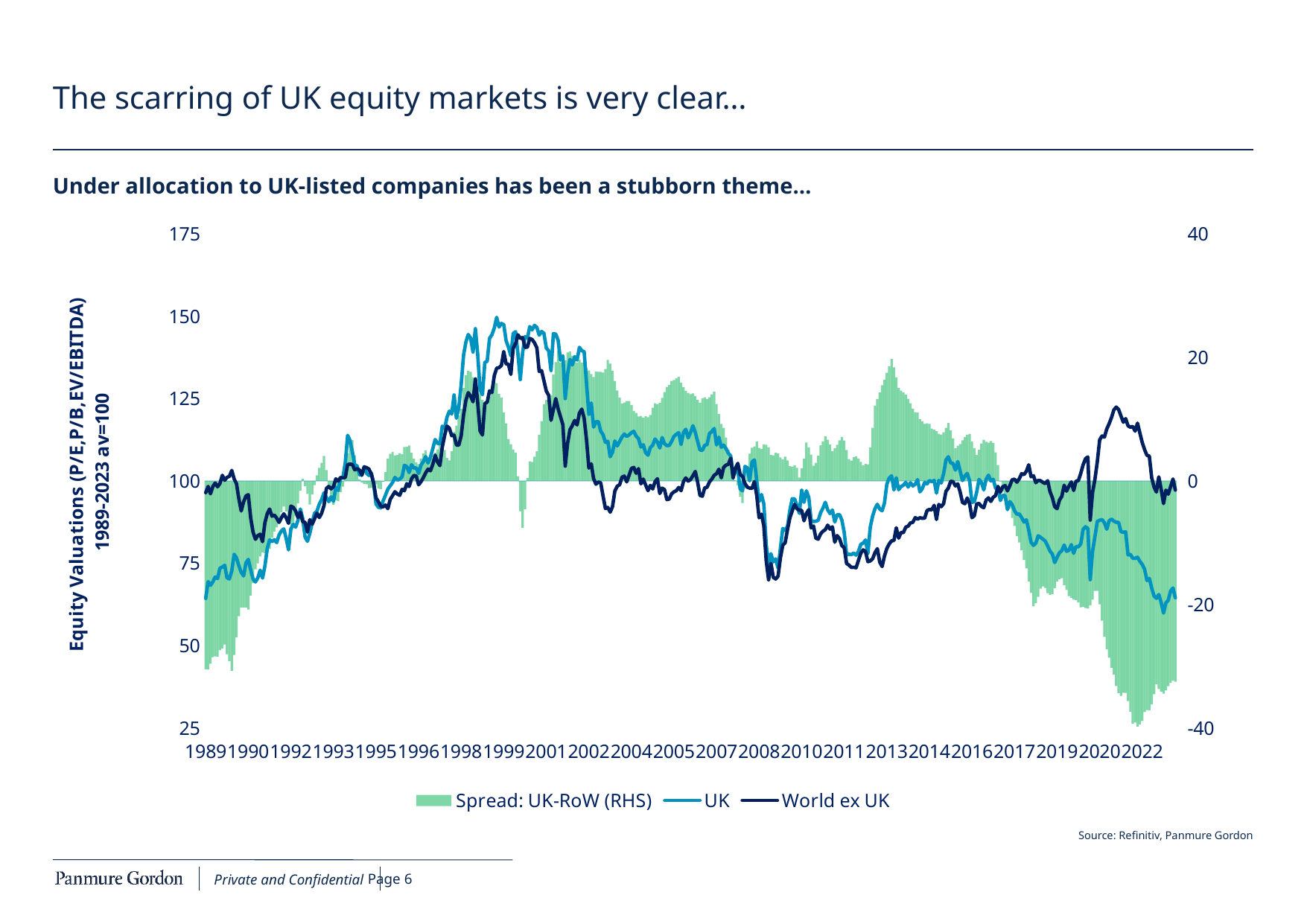
Does the UK series rise or fall between 2020 and 2022? fall In 1989, which series is higher: UK or World ex UK? World ex UK Is the value of the UK series in 1999 greater or less than 125? greater Is the Spread: UK-RoW (RHS) value in 1989 greater or less than 0? less Is the value of the UK series at the end of 2022 greater or less than 75? less What kind of chart is shown on the slide? A combination chart with two line series and a shaded area/bar series How many series does the chart legend list? 3 What is the label of the left-hand vertical axis of the chart? Equity Valuations (P/E,P/B,EV/EBITDA) 1989-2023 av=100 Which series in the chart is plotted on the right-hand axis? Spread: UK-RoW (RHS) In 2020, which series is higher: UK or World ex UK? World ex UK